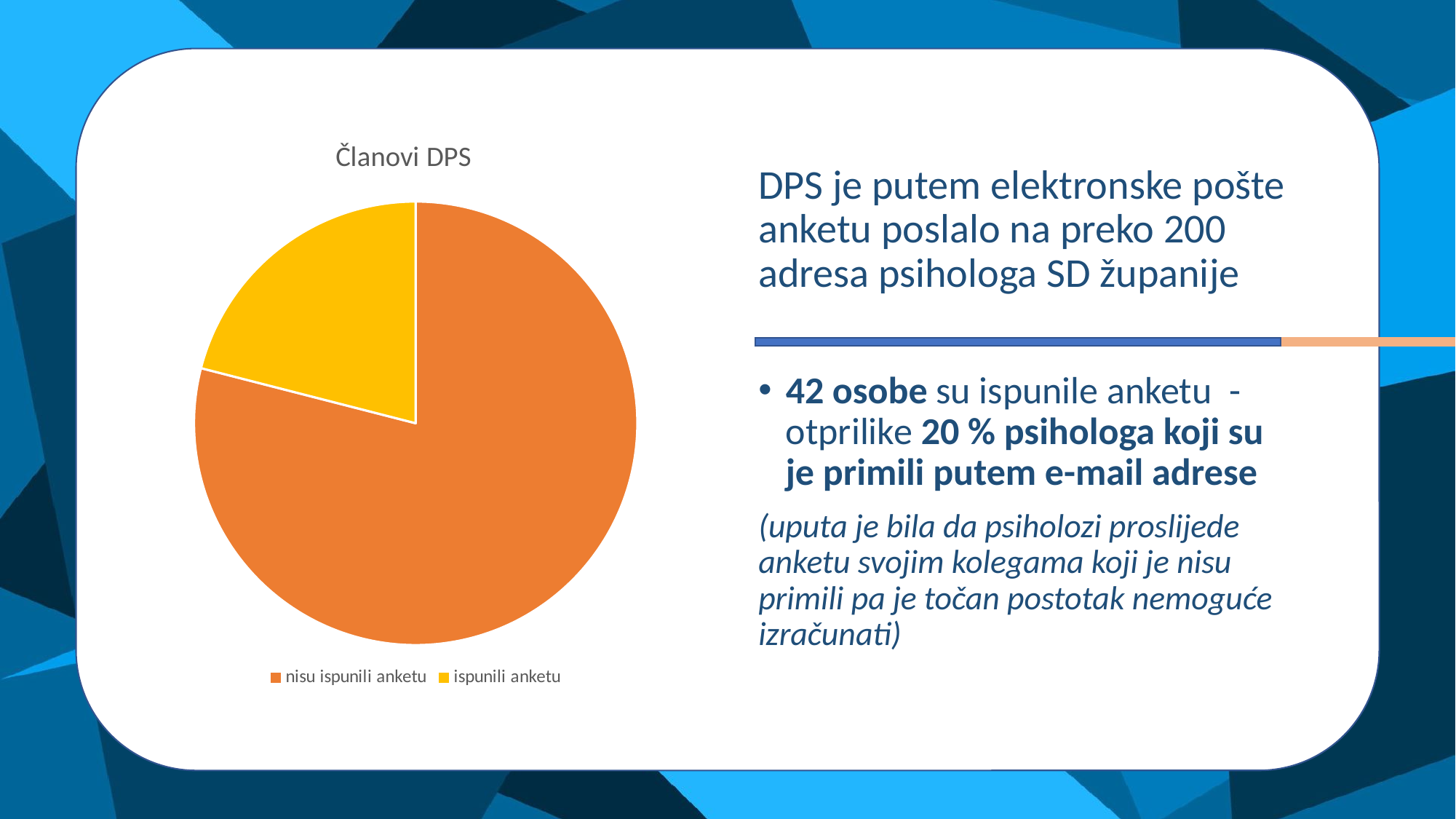
Which slice is larger, "nisu ispunili anketu" or "ispunili anketu"? nisu ispunili anketu Which category has the largest slice of the pie? nisu ispunili anketu What colour is the "ispunili anketu" slice? yellow What kind of chart is shown on the slide? pie chart Which category has the smallest slice of the pie? ispunili anketu What is the title of the chart? Članovi DPS How many slices does the pie chart have? 2 How many entries does the chart legend list? 2